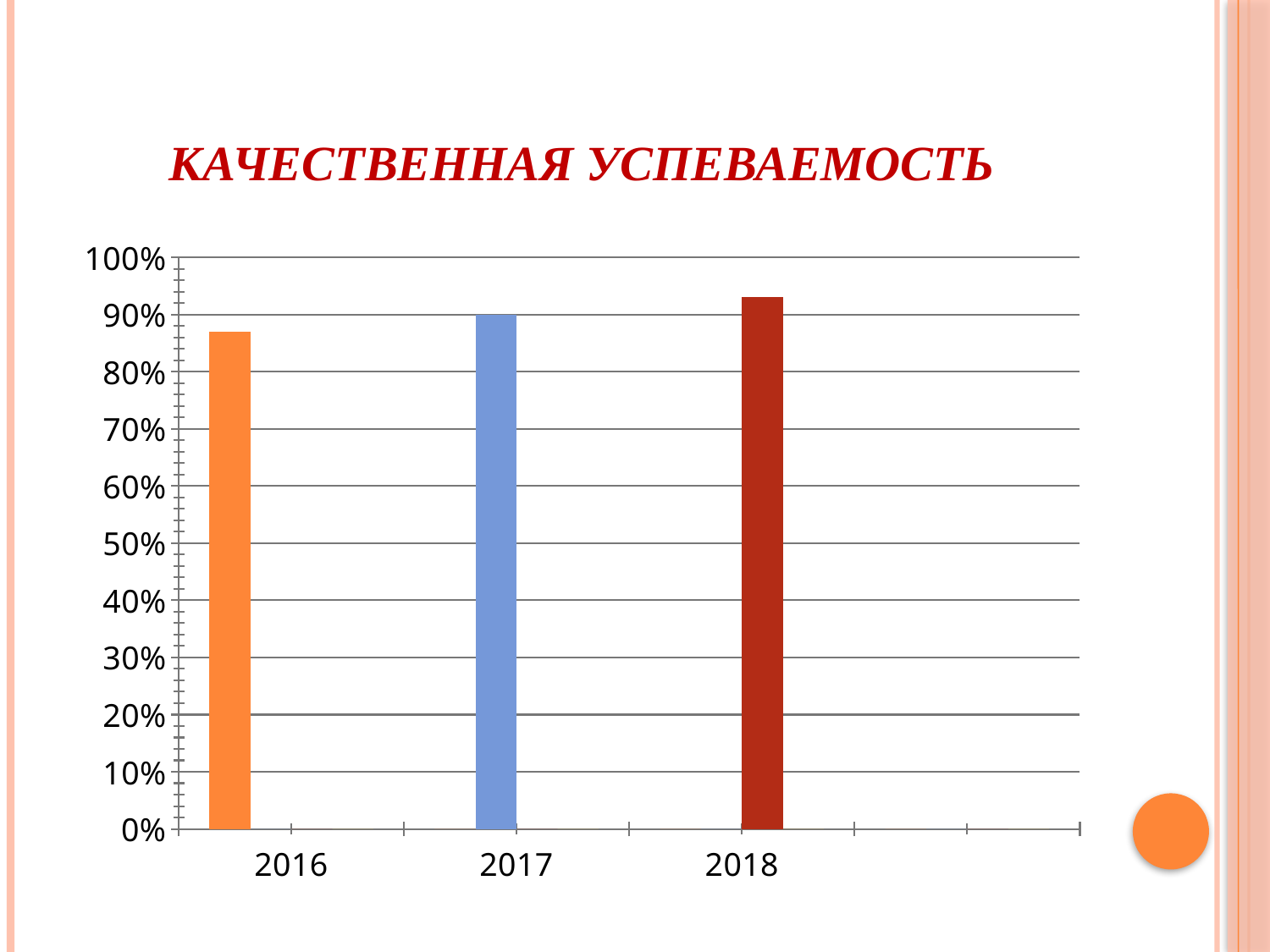
Is the value for 2016 greater or less than 90%? less What kind of chart is shown on the slide? bar chart Which is larger, the value for 2016 or the value for 2018? 2018 Is the value for 2016 greater or less than 80%? greater Is the value for 2018 greater or less than 90%? greater Which year has the lowest value in the chart? 2016 Which year has the highest value in the chart? 2018 What is the title of the slide above the chart? КАЧЕСТВЕННАЯ УСПЕВАЕМОСТЬ What colour is the bar for 2017? blue Which is larger, the value for 2017 or the value for 2016? 2017 Do the values rise or fall from 2016 to 2018? rise How many years are shown on the x axis of the chart? 3